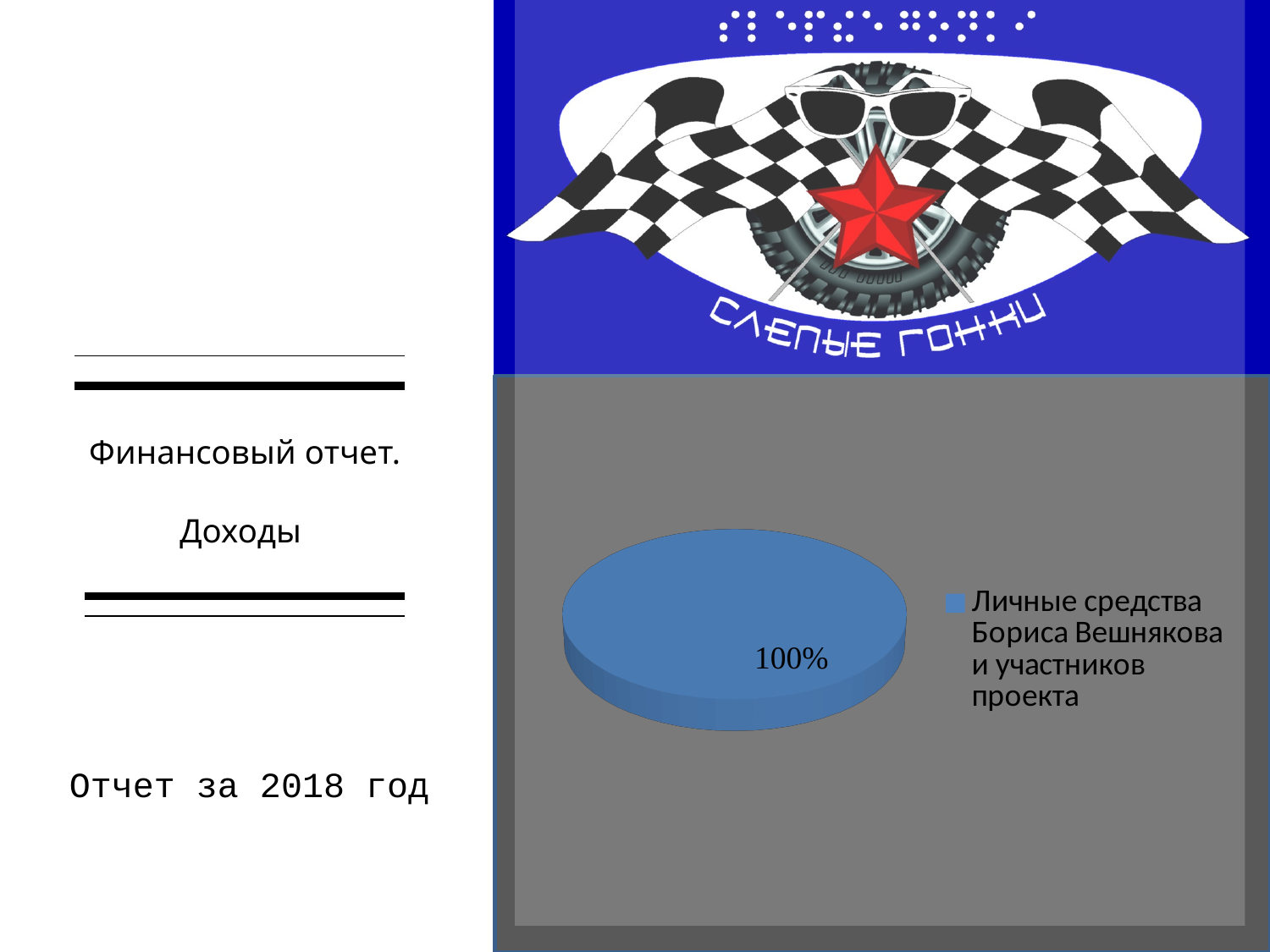
How many slices does the pie chart have? 1 What share of the pie does the slice labelled in the legend as 'Личные средства Бориса Вешнякова и участников проекта' represent? 100% What colour is the single slice of the pie chart? blue What value is printed as the data label on the pie chart? 100% What kind of chart is shown on the slide? pie chart How many entries does the legend of the pie chart list? 1 What is the legend entry of the pie chart? Личные средства Бориса Вешнякова и участников проекта Is the value shown on the pie chart greater or less than 50%? greater